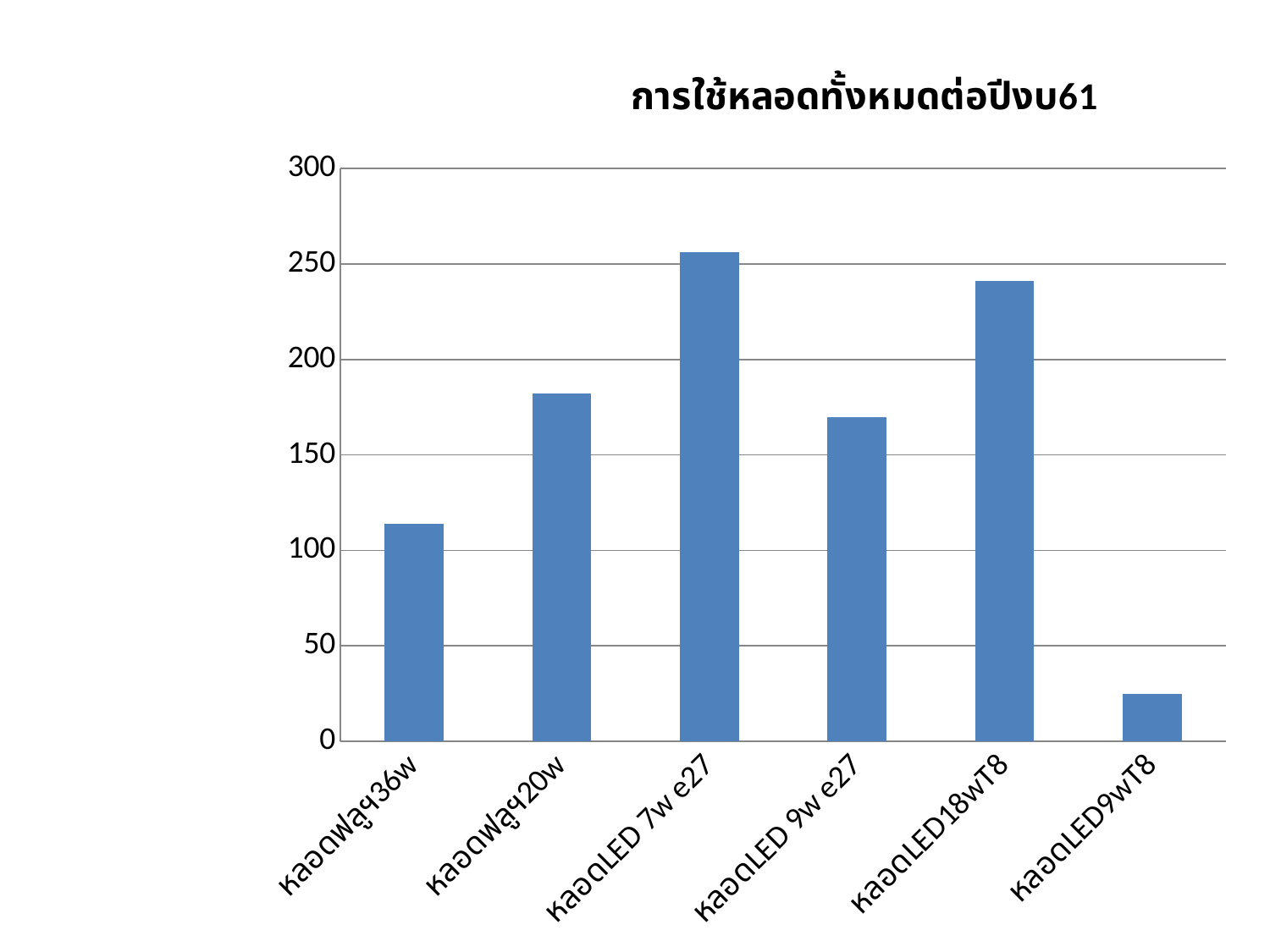
Which category has the highest value? หลอดLED 7w e27 Is the value for หลอดLED9wT8 greater or less than 50? less Which is larger, the value for หลอดฟลูฯ20w or the value for หลอดLED 9w e27? หลอดฟลูฯ20w Which is larger, the value for หลอดLED18wT8 or the value for หลอดฟลูฯ36w? หลอดLED18wT8 What kind of chart is shown on the slide? bar chart How many categories are shown on the x axis of the chart? 6 Is the value for หลอดฟลูฯ36w greater or less than 100? greater Is the value for หลอดฟลูฯ20w greater or less than 150? greater Which category has the lowest value? หลอดLED9wT8 What is the title of the chart? การใช้หลอดทั้งหมดต่อปีงบ61